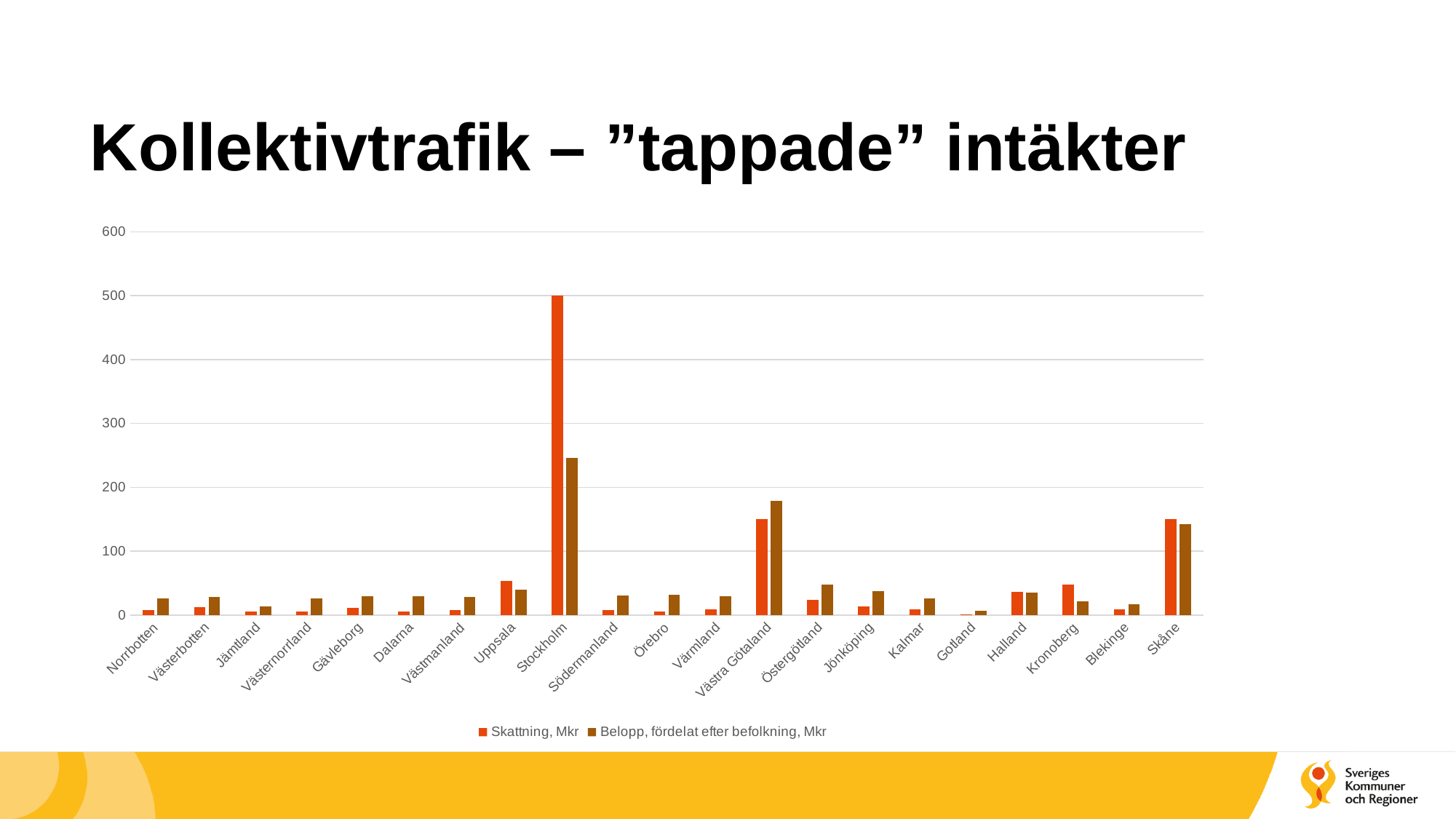
Which region has the highest value for Belopp, fördelat efter befolkning, Mkr? Stockholm What is the title of the slide containing the chart? Kollektivtrafik – "tappade" intäkter Is the Skattning, Mkr value for Västra Götaland greater or less than 100? greater For Stockholm, which is larger: Skattning, Mkr or Belopp, fördelat efter befolkning, Mkr? Skattning, Mkr Which region has the lowest value for Skattning, Mkr? Gotland Is the Belopp, fördelat efter befolkning, Mkr value for Stockholm greater or less than 200? greater What kind of chart is shown on the slide? bar chart How many series does the legend list? 2 For Västra Götaland, which is larger: Skattning, Mkr or Belopp, fördelat efter befolkning, Mkr? Belopp, fördelat efter befolkning, Mkr Is the Skattning, Mkr value for Uppsala greater or less than 100? less How many regions are shown on the x axis? 21 Which region has the highest value for Skattning, Mkr? Stockholm